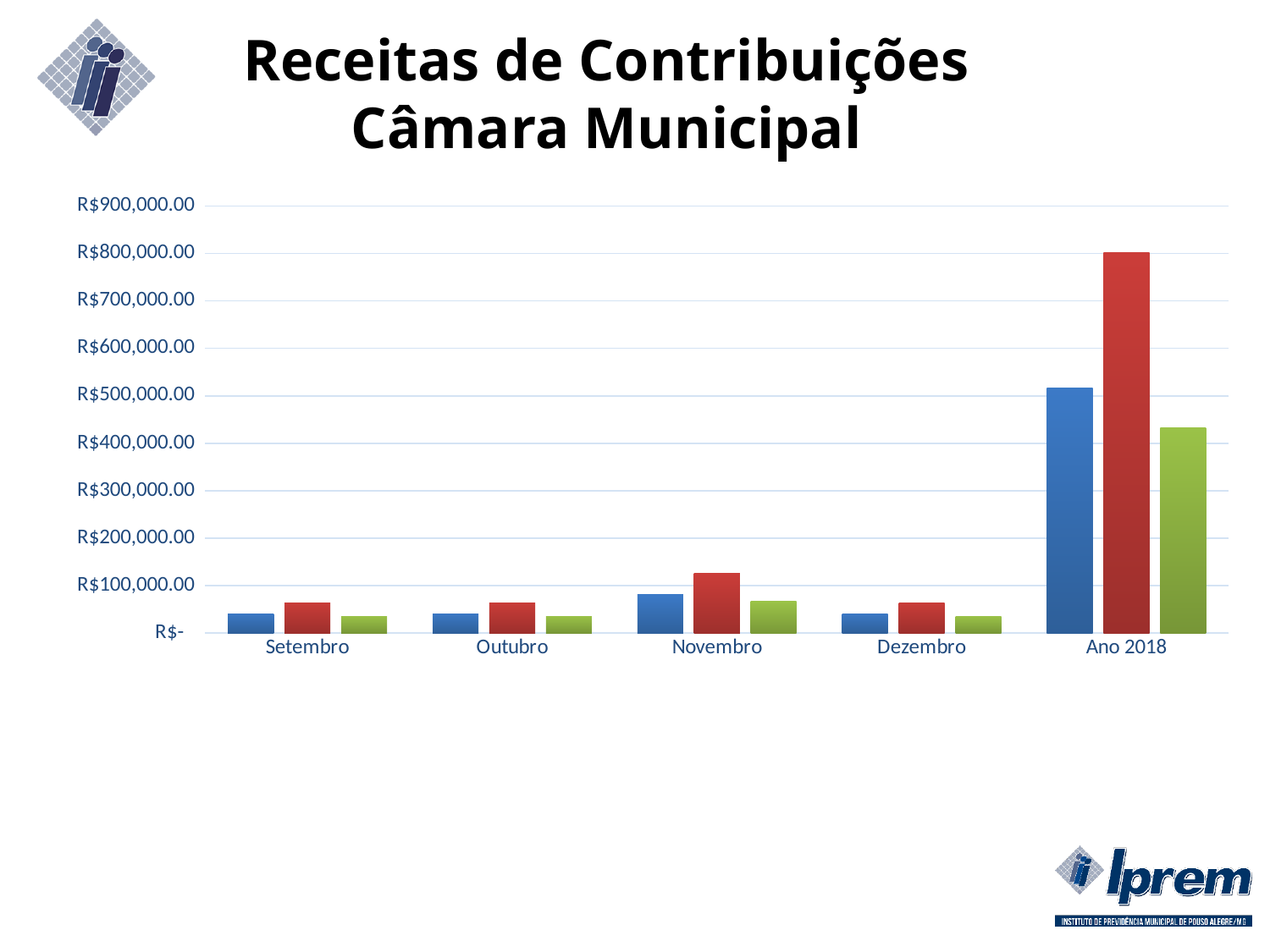
Which is larger, the red bar for Novembro or the red bar for Outubro? Novembro Which category on the x axis has the tallest bars? Ano 2018 What kind of chart is shown on the slide? bar chart Is the value of the green bar for Ano 2018 greater or less than R$500,000.00? less Is the value of the blue bar for Novembro greater or less than R$100,000.00? less What is the title of the chart on the slide? Receitas de Contribuições Câmara Municipal How many categories are shown on the x axis of the chart? 5 Is the value of the red bar for Novembro greater or less than R$100,000.00? greater Among the monthly categories (Setembro to Dezembro), which month has the tallest bars? Novembro Which coloured bar is the tallest in the Ano 2018 category? red